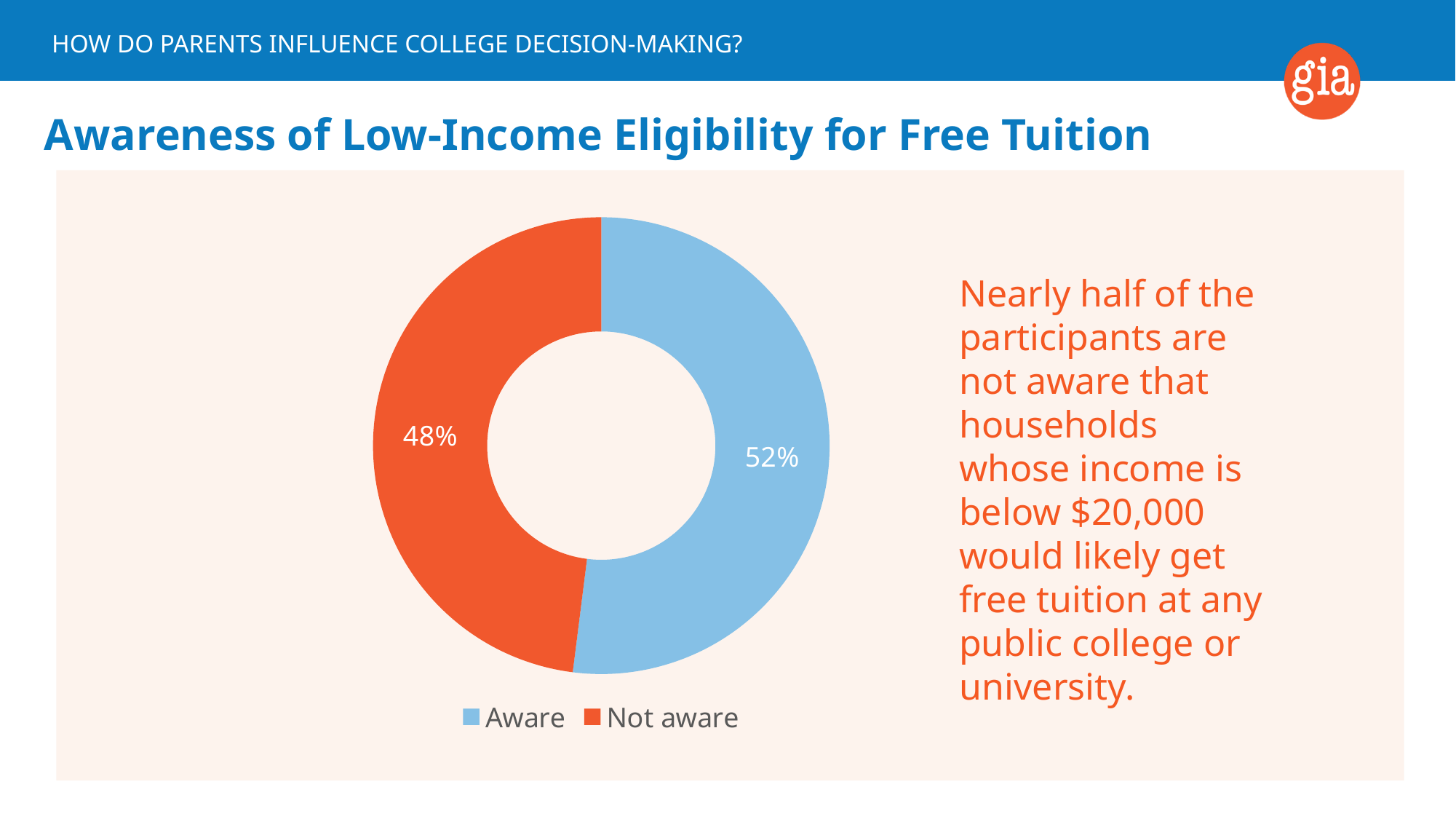
What is the difference in percentage points between the Aware and Not aware shares? 4 What is the title of the chart on the slide? Awareness of Low-Income Eligibility for Free Tuition What percentage of participants are not aware of low-income eligibility for free tuition? 48% Which category has the larger share: Aware or Not aware? Aware What percentage of participants are aware of low-income eligibility for free tuition? 52% What colour represents the Not aware category in the chart? Orange What share of the pie does the Not aware slice represent? 48% What kind of chart is shown on the slide? Pie chart (doughnut) Which category has the smallest share in the chart? Not aware Which category has the largest share in the chart? Aware How many categories does the chart show? 2